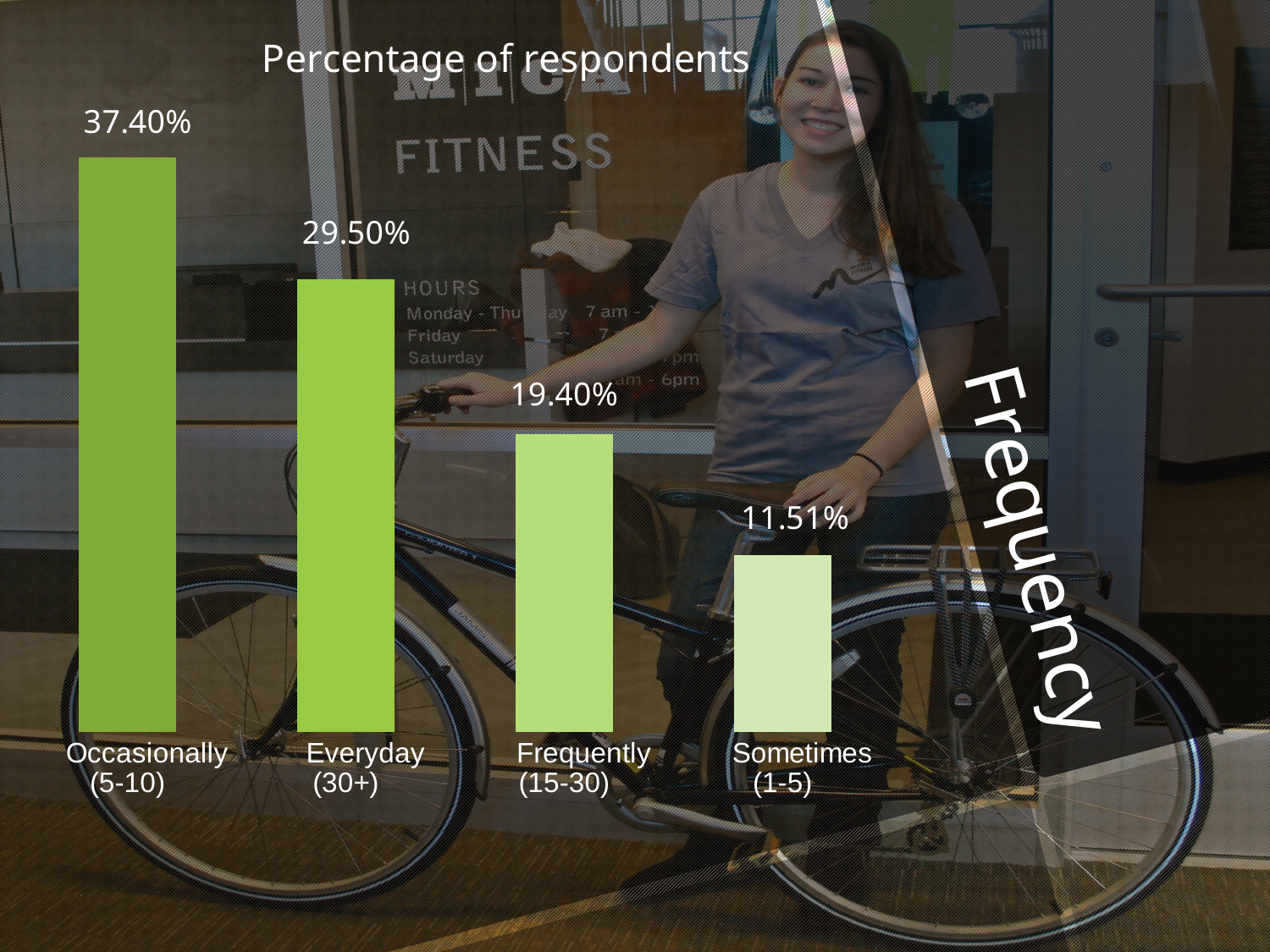
What kind of chart is shown on the slide? Bar chart What is the title of the chart? Percentage of respondents Which is larger, the value for Everyday (30+) or the value for Frequently (15-30)? Everyday (30+) How many categories are shown in the chart? 4 What is the difference between the values for Occasionally (5-10) and Everyday (30+)? 7.90% What is the difference between the values for Frequently (15-30) and Sometimes (1-5)? 7.89% What is the value for Frequently (15-30)? 19.40% Which category has the highest percentage of respondents? Occasionally (5-10) What is the value for Sometimes (1-5)? 11.51% What is the value for Everyday (30+)? 29.50% What is the value for Occasionally (5-10)? 37.40% Which category has the lowest percentage of respondents? Sometimes (1-5)